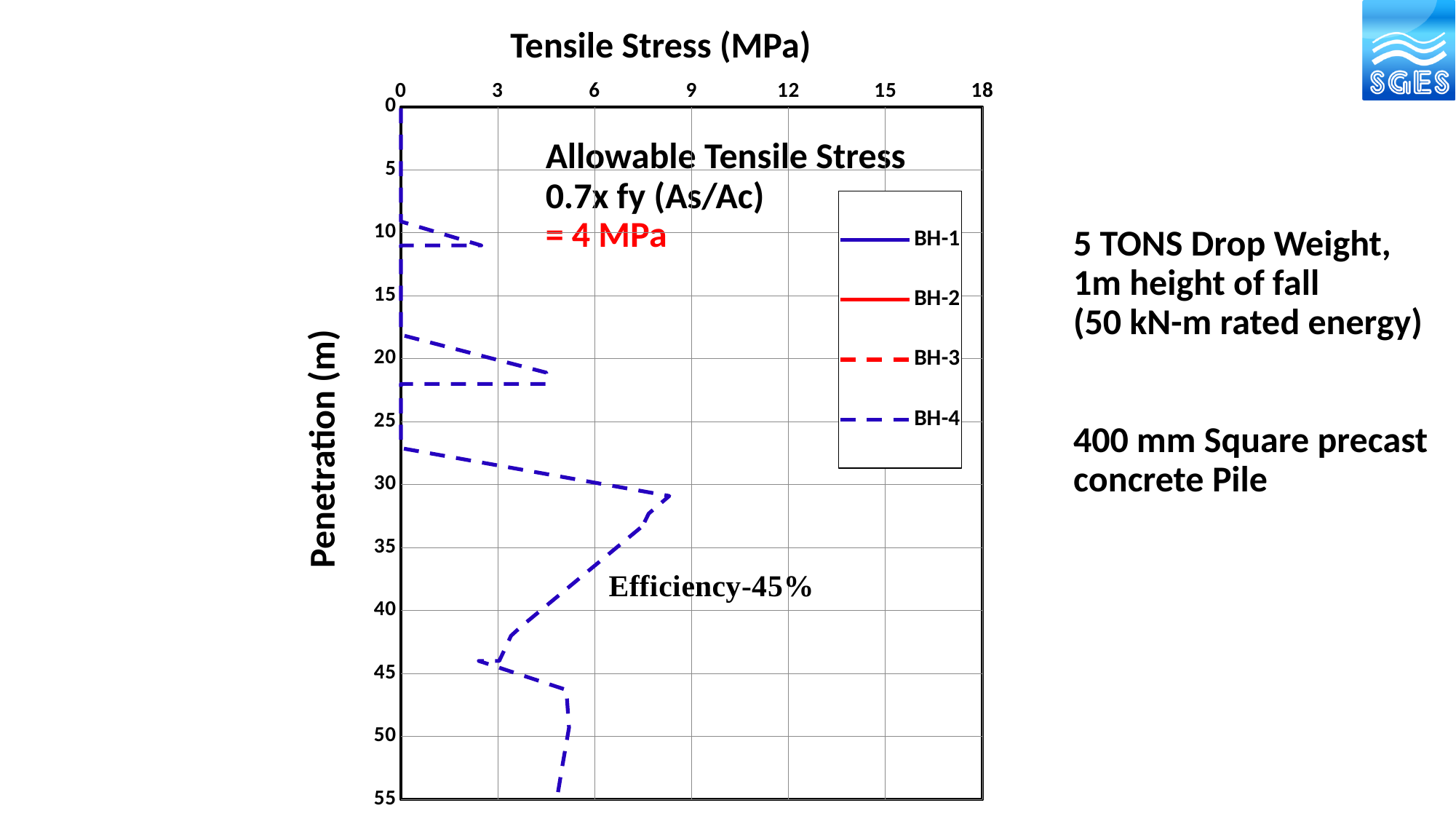
What is the highest value shown on the Tensile Stress axis? 18 Is the maximum tensile stress reached by BH-4 greater or less than 6 MPa? greater Is the tensile stress for BH-4 at a penetration of 55 m greater or less than 3 MPa? greater Is the tensile stress for BH-4 at a penetration of about 11 m greater or less than 3 MPa? less What is the title of the vertical axis? Penetration (m) How many series does the legend list? 4 What is the title of the horizontal axis? Tensile Stress (MPa) What is the deepest penetration value shown on the vertical axis? 55 What type of chart is shown on the slide? line chart